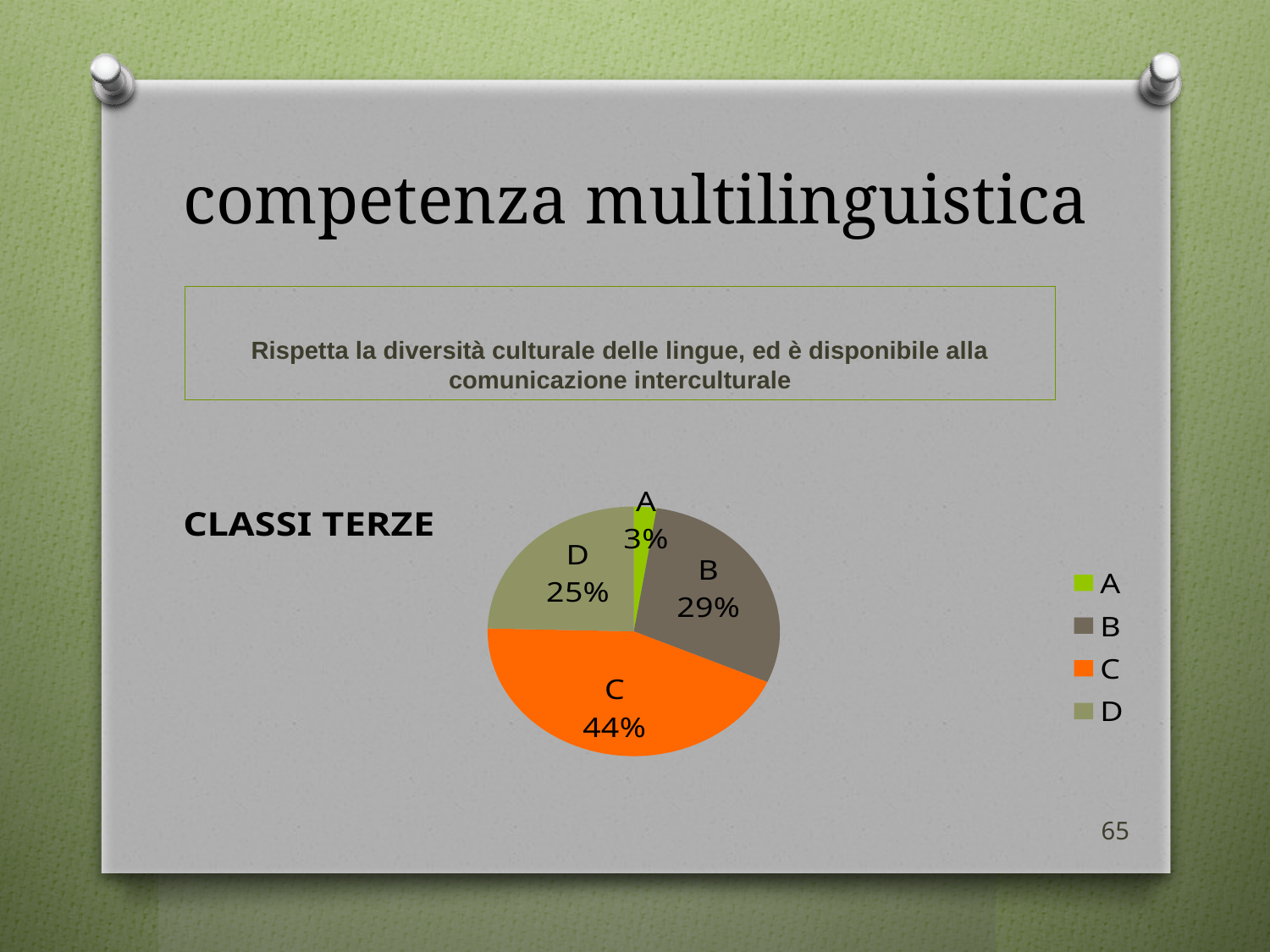
What percentage does slice C represent in the pie chart? 44% What percentage does slice D represent in the pie chart? 25% What percentage does slice B represent in the pie chart? 29% How many entries does the legend of the pie chart list? 4 Which slice of the pie chart is the smallest? A What kind of chart is shown on the slide? pie chart What percentage does slice A represent in the pie chart? 3% What is the difference in percentage points between slice C and slice B? 15 What colour is slice C in the pie chart? orange Which slice of the pie chart is the largest? C Which is larger in the pie chart, slice B or slice D? B How many slices does the pie chart have? 4